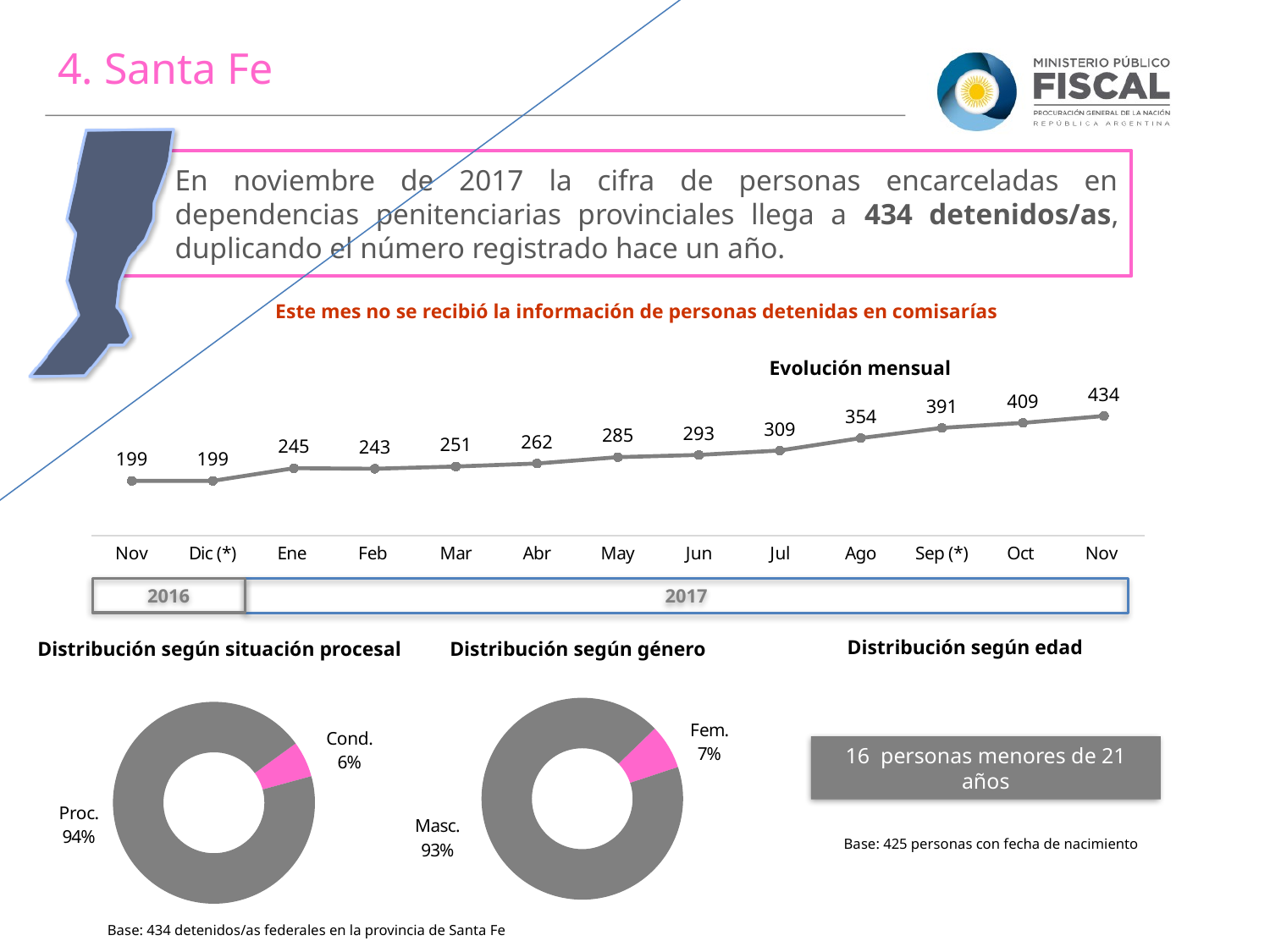
In the 'Distribución según género' chart, what share is Masc.? 93% In the 'Distribución según género' chart, which category is the smallest? Fem. In the 'Evolución mensual' chart, which month has the highest value? Nov (2017) In the 'Evolución mensual' chart, what is the difference between the value for Nov 2017 and the value for Oct? 25 In the 'Evolución mensual' chart, what is the value for Feb? 243 In the 'Evolución mensual' chart, which is larger, the value for Jul or the value for Jun? Jul In the 'Distribución según situación procesal' chart, what share is Cond.? 6% How many data points are plotted in the 'Evolución mensual' chart? 13 In the 'Evolución mensual' chart, what is the value for Ago? 354 What kind of chart is 'Distribución según situación procesal'? Pie (donut) chart In the 'Evolución mensual' chart, do the values generally rise or fall from Nov 2016 to Nov 2017? Rise What kind of chart is 'Evolución mensual'? Line chart